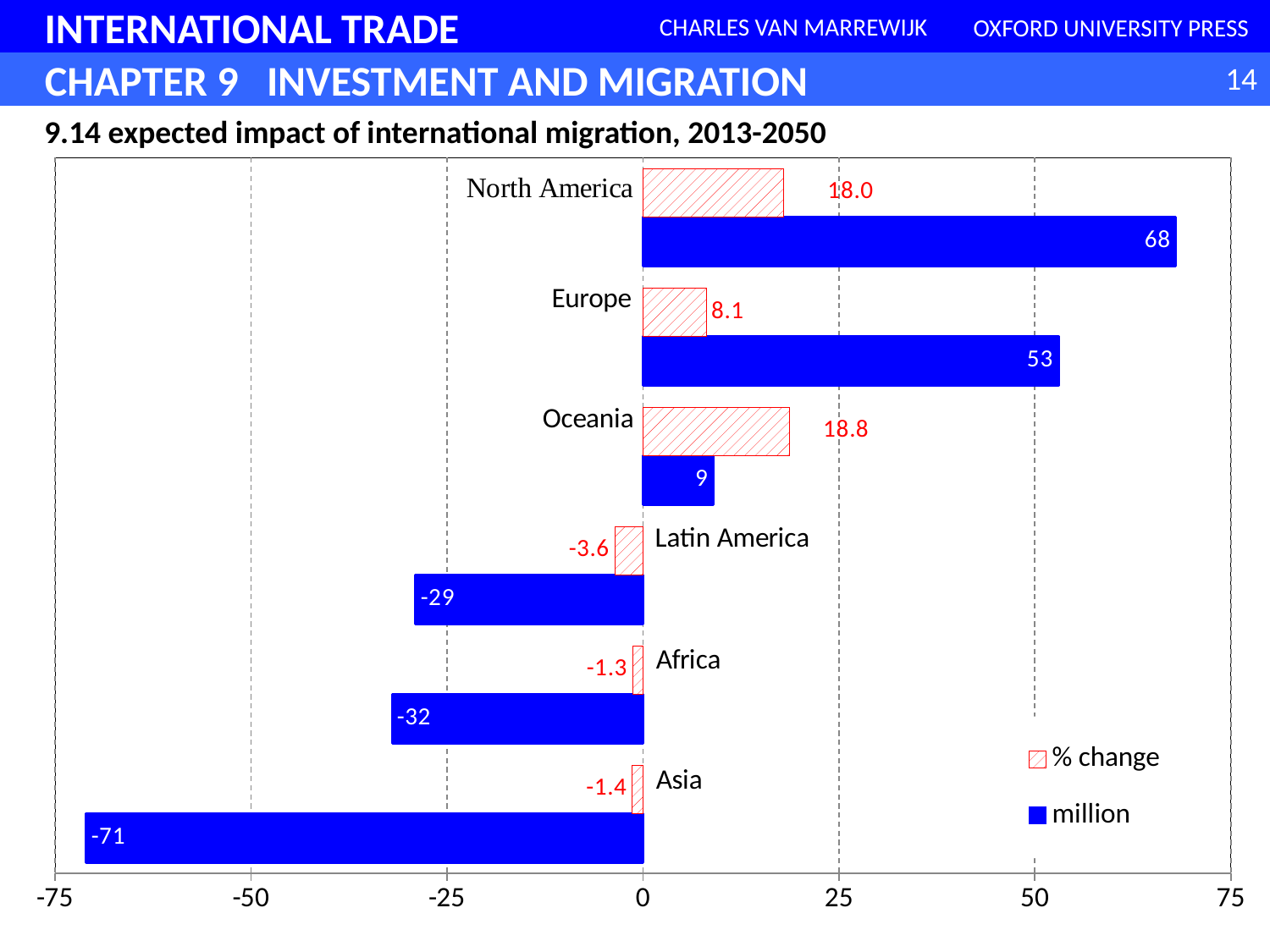
Which region has the highest 'million' value? North America What is the 'million' value for North America? 68 What is the '% change' value for Oceania? 18.8 What is the difference between the 'million' values for North America and Europe? 15 What kind of chart is shown on the slide? Bar chart How many series does the legend list? 2 How many regions are shown in the chart? 6 What is the '% change' value for Latin America? -3.6 What is the 'million' value for Asia? -71 Which region has the lowest 'million' value? Asia Which region has the highest '% change' value? Oceania Which is larger, the 'million' value for Latin America or for Africa? Latin America